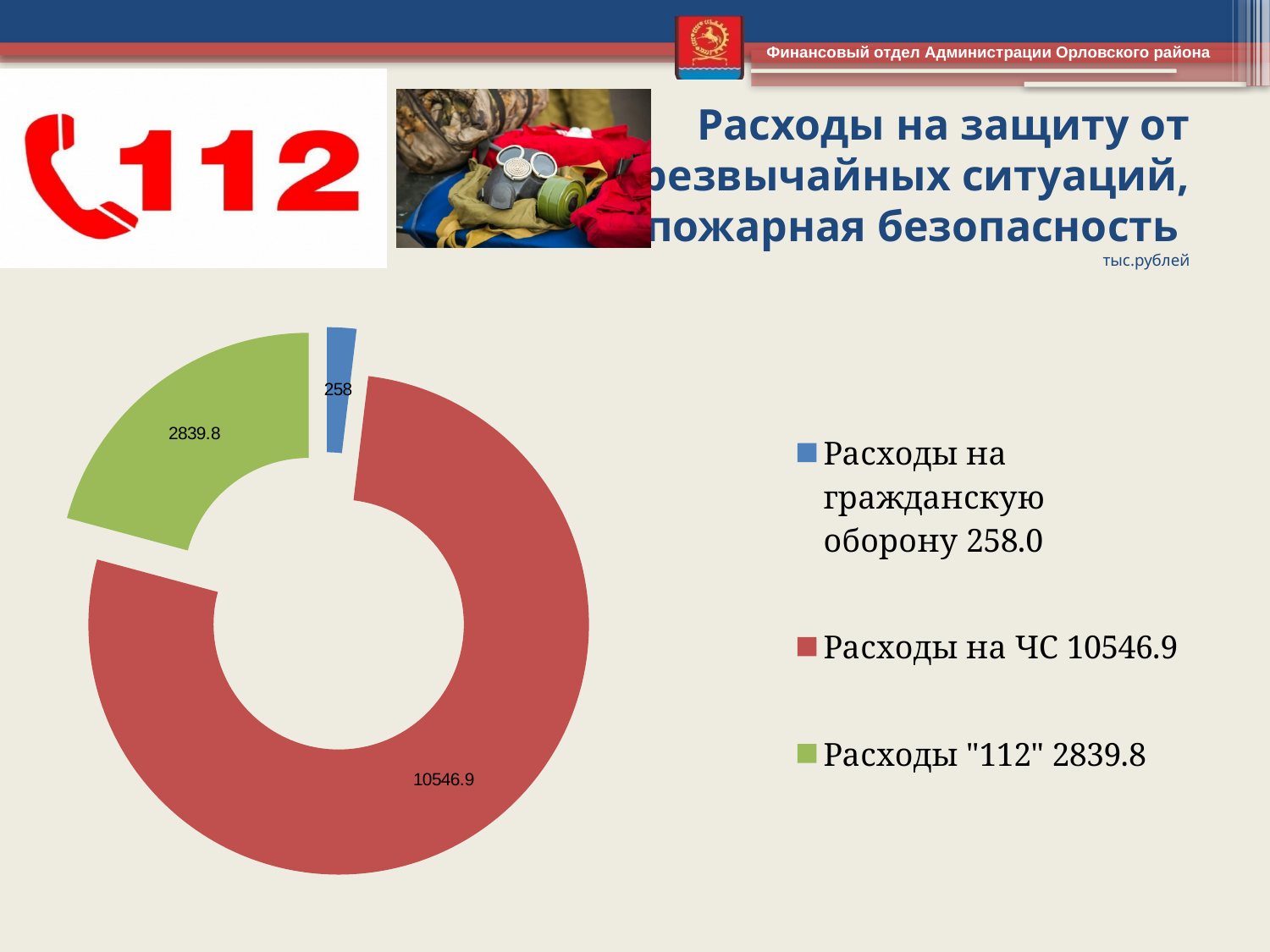
What is the value for "Расходы на ЧС" in the chart? 10546.9 What is the difference between the values for "Расходы "112"" and "Расходы на гражданскую оборону"? 2581.8 What colour is the slice for "Расходы на ЧС"? Red What is the total of all values shown in the chart? 13644.7 Which category has the largest value in the chart? Расходы на ЧС Which is larger: the value for "Расходы "112"" or the value for "Расходы на гражданскую оборону"? Расходы "112" Which category has the smallest value in the chart? Расходы на гражданскую оборону What is the value for "Расходы "112"" in the chart? 2839.8 What type of chart is shown on the slide? Doughnut (pie) chart What is the difference between the values for "Расходы на ЧС" and "Расходы "112""? 7707.1 How many categories does the chart show? 3 What is the value for "Расходы на гражданскую оборону" in the chart? 258